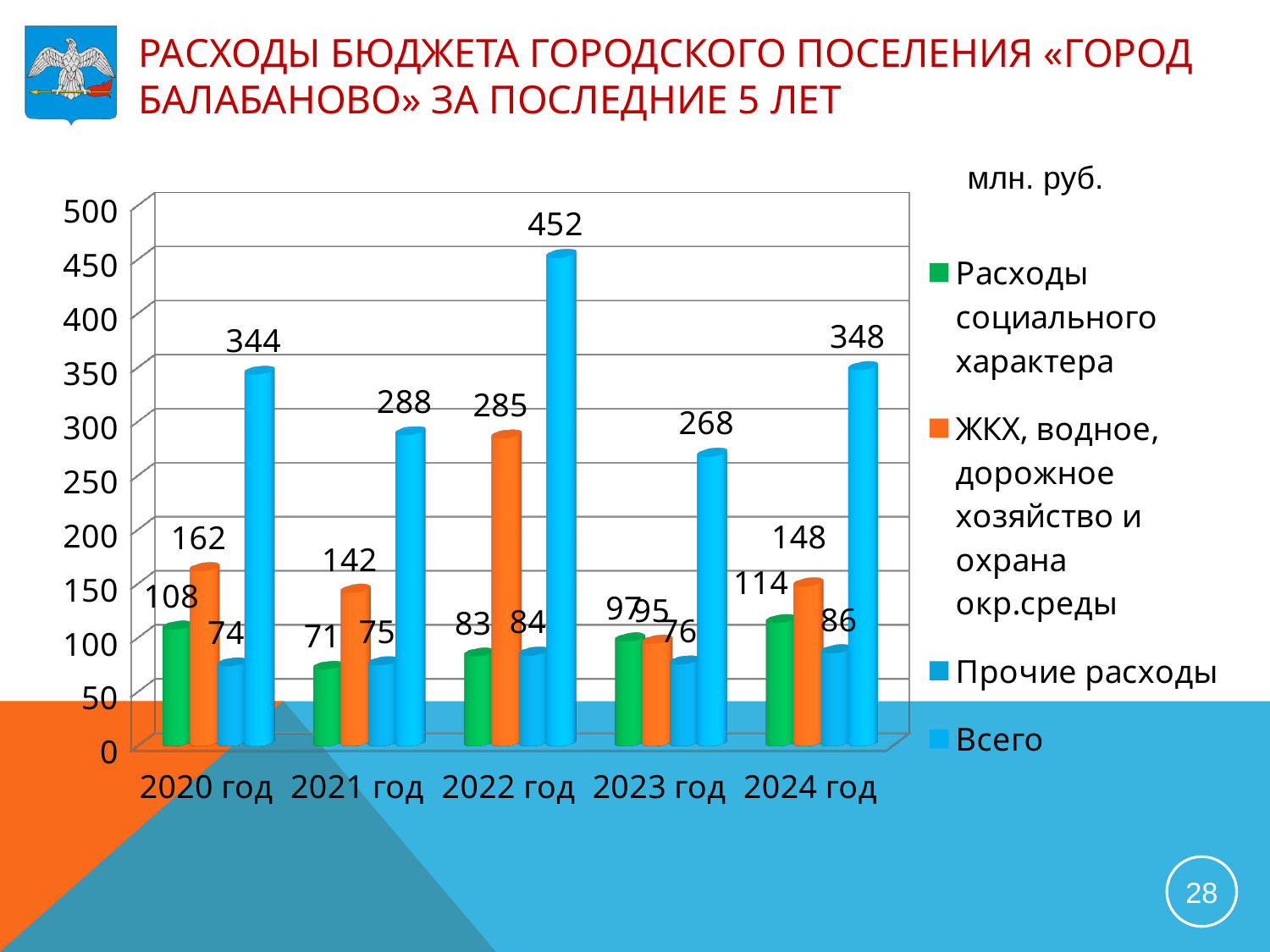
What is the difference between «Всего» in 2022 год and «Всего» in 2021 год? 164 What is the value of «Прочие расходы» for 2023 год? 76 Which is larger: «Расходы социального характера» in 2020 год or «Расходы социального характера» in 2021 год? 2020 год How many years are shown on the x axis? 5 In which year is «Всего» the highest? 2022 год What kind of chart is shown on the slide? Bar chart What unit is indicated above the legend? млн. руб. How many series does the legend list? 4 What is the value of «Всего» for 2022 год? 452 In which year is «Всего» the lowest? 2023 год What is the value of «Расходы социального характера» for 2024 год? 114 What is the value of «ЖКХ, водное, дорожное хозяйство и охрана окр.среды» for 2020 год? 162